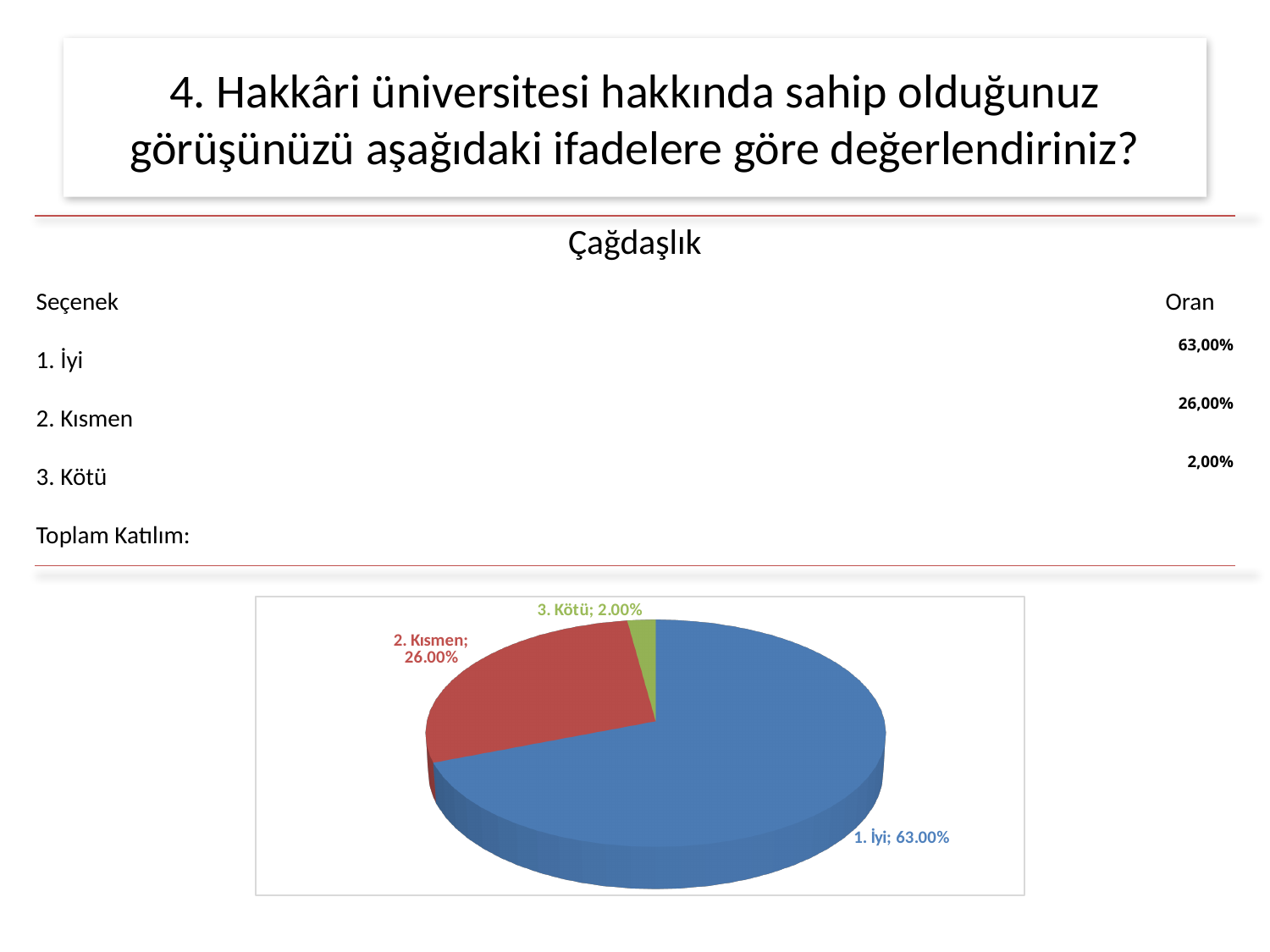
How many slices does the pie chart have? 3 What is the value shown for the slice "2. Kısmen" in the pie chart? 26.00% What colour is the slice for "1. İyi" in the pie chart? blue What is the difference between the values for "1. İyi" and "2. Kısmen" in the pie chart? 37.00% What is the difference between the values for "2. Kısmen" and "3. Kötü" in the pie chart? 24.00% Which slice of the pie chart is the smallest? 3. Kötü Which slice of the pie chart is the largest? 1. İyi Which is larger in the pie chart, "2. Kısmen" or "3. Kötü"? 2. Kısmen What is the value shown for the slice "1. İyi" in the pie chart? 63.00% What is the value shown for the slice "3. Kötü" in the pie chart? 2.00% What kind of chart is shown on the slide? pie chart What colour is the slice for "2. Kısmen" in the pie chart? red